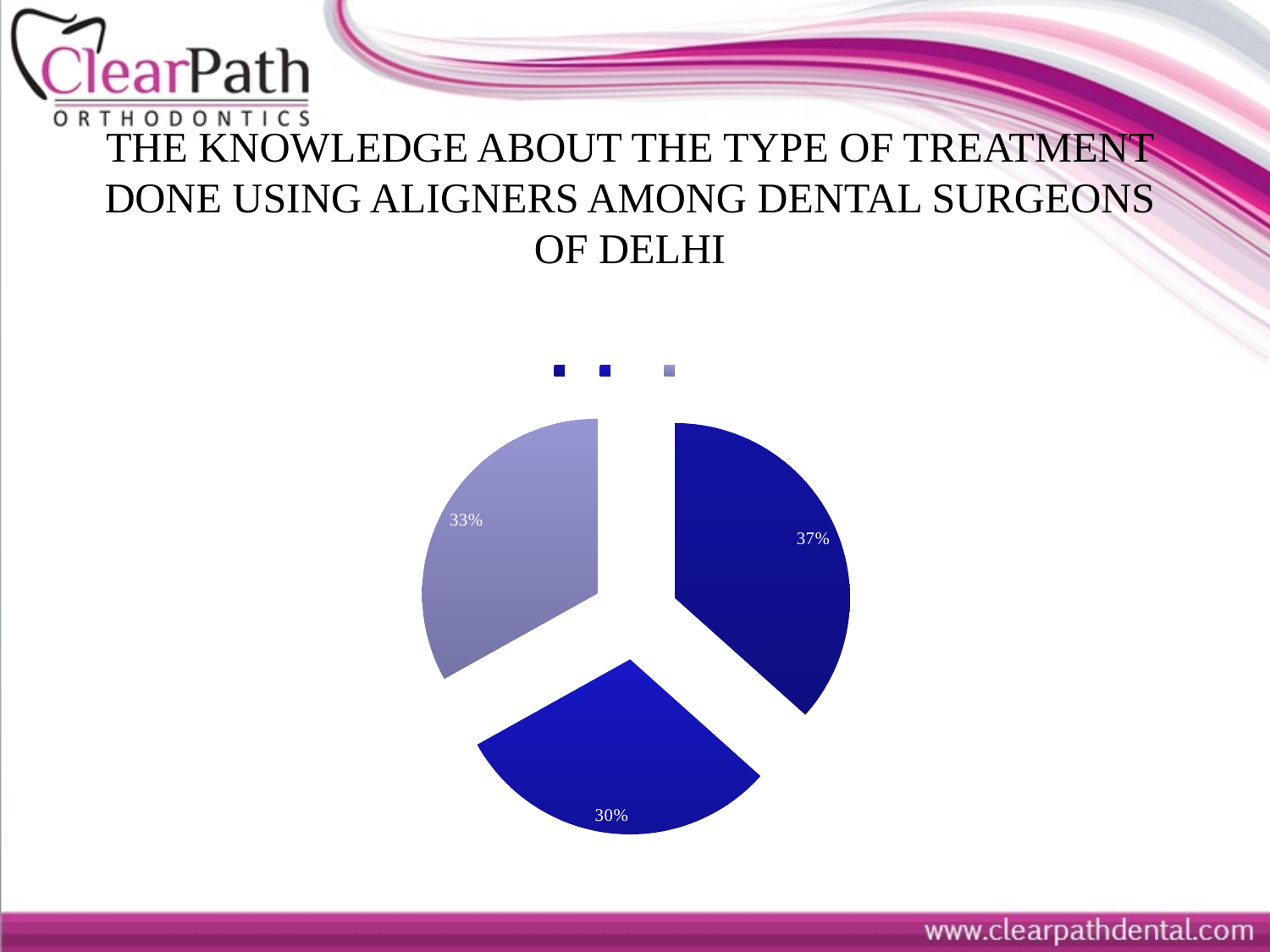
Which slice is larger: the light purple slice on the left or the blue slice at the bottom? the light purple slice on the left (33%) What is the smallest percentage shown on the pie chart? 30% How many entries does the legend above the pie chart show? 3 What kind of chart is shown on the slide? pie chart What is the largest percentage shown on the pie chart? 37% What is the difference between the largest slice (37%) and the smallest slice (30%) of the pie chart? 7% What is the title of the slide containing the pie chart? THE KNOWLEDGE ABOUT THE TYPE OF TREATMENT DONE USING ALIGNERS AMONG DENTAL SURGEONS OF DELHI What do the three slice percentages on the pie chart add up to? 100% What percentage is labelled on the dark blue slice on the right side of the pie chart? 37% What percentage is labelled on the light purple slice on the left side of the pie chart? 33% How many slices does the pie chart have? 3 What percentage is labelled on the blue slice at the bottom of the pie chart? 30%